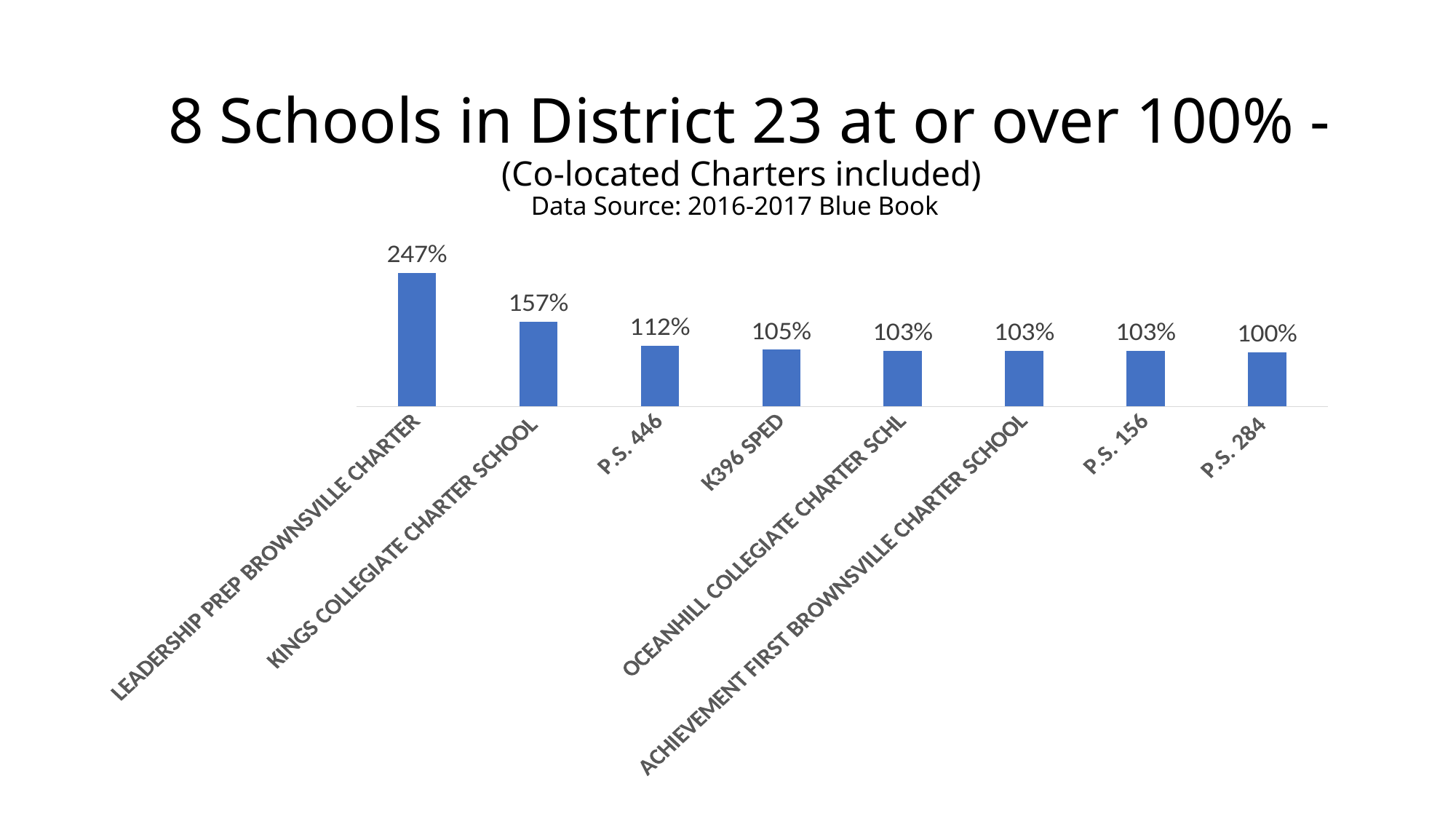
Which is larger, the value for P.S. 446 or the value for K396 SPED? P.S. 446 What is the difference between the values for LEADERSHIP PREP BROWNSVILLE CHARTER and KINGS COLLEGIATE CHARTER SCHOOL? 90% What is the value for LEADERSHIP PREP BROWNSVILLE CHARTER? 247% How many schools are shown in the chart? 8 What is the value for KINGS COLLEGIATE CHARTER SCHOOL? 157% Do the values rise or fall from left to right across the chart? Fall What is the value for P.S. 446? 112% Which school has the lowest value? P.S. 284 What is the value for K396 SPED? 105% What kind of chart is shown on the slide? Bar chart Which school has the highest value? LEADERSHIP PREP BROWNSVILLE CHARTER What is the value for P.S. 284? 100%